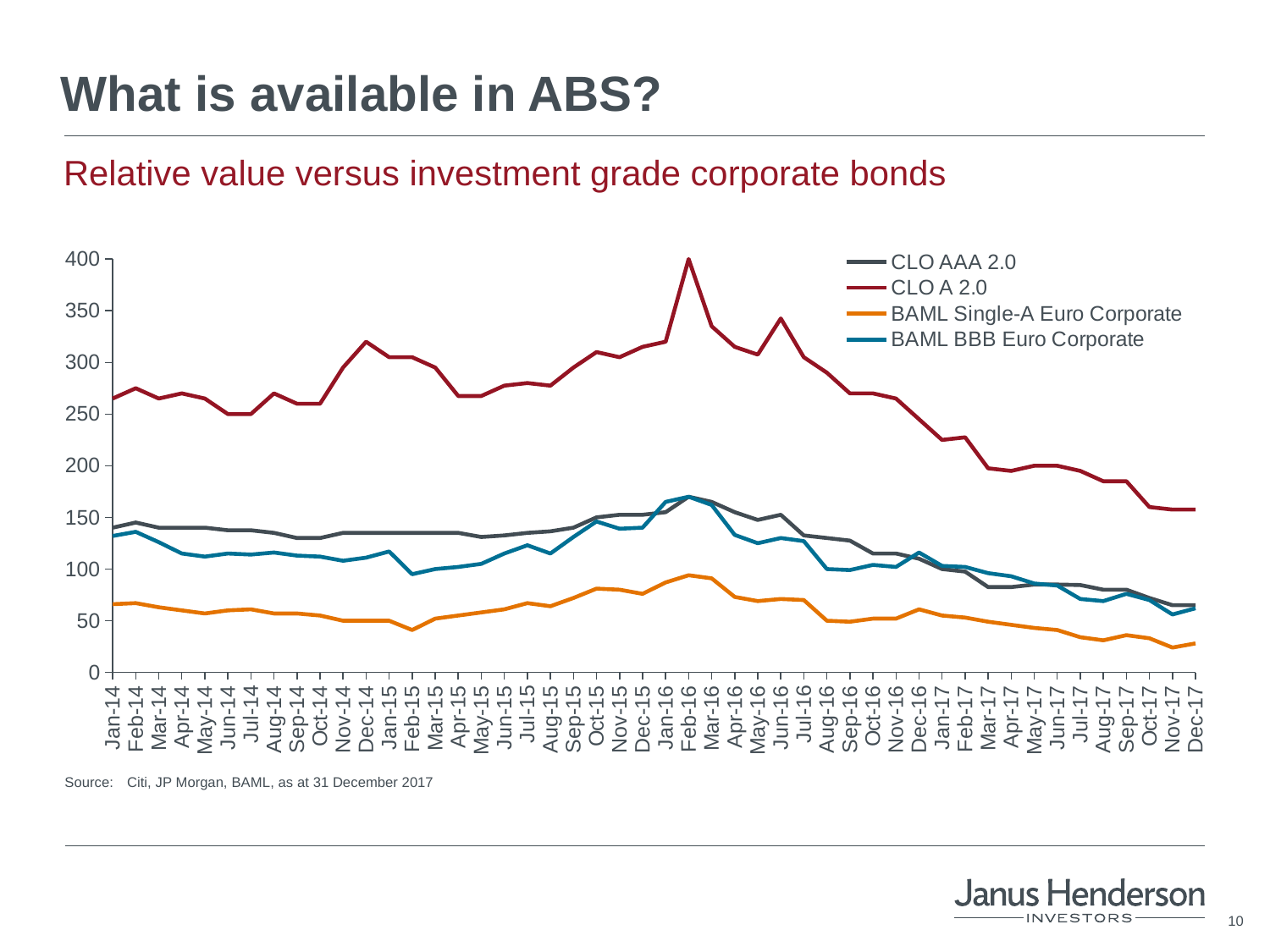
Does the CLO A 2.0 series rise or fall from Feb-16 to Dec-17? Fall Which is higher in Jan-14, CLO A 2.0 or CLO AAA 2.0? CLO A 2.0 How many series does the legend list? 4 How many monthly points are plotted along the x axis, from Jan-14 to Dec-17? 48 Which series reaches the highest value on the chart? CLO A 2.0 Is the value for CLO A 2.0 in Feb-16 greater or less than 350? greater Which series has the lowest values throughout the chart? BAML Single-A Euro Corporate What kind of chart is shown on the slide? Line chart In which month does the CLO A 2.0 series reach its peak? Feb-16 What is the subtitle of the chart on the slide? Relative value versus investment grade corporate bonds Is the value for BAML Single-A Euro Corporate in Nov-17 greater or less than 50? less Is the value for CLO A 2.0 in Dec-14 greater or less than 300? greater